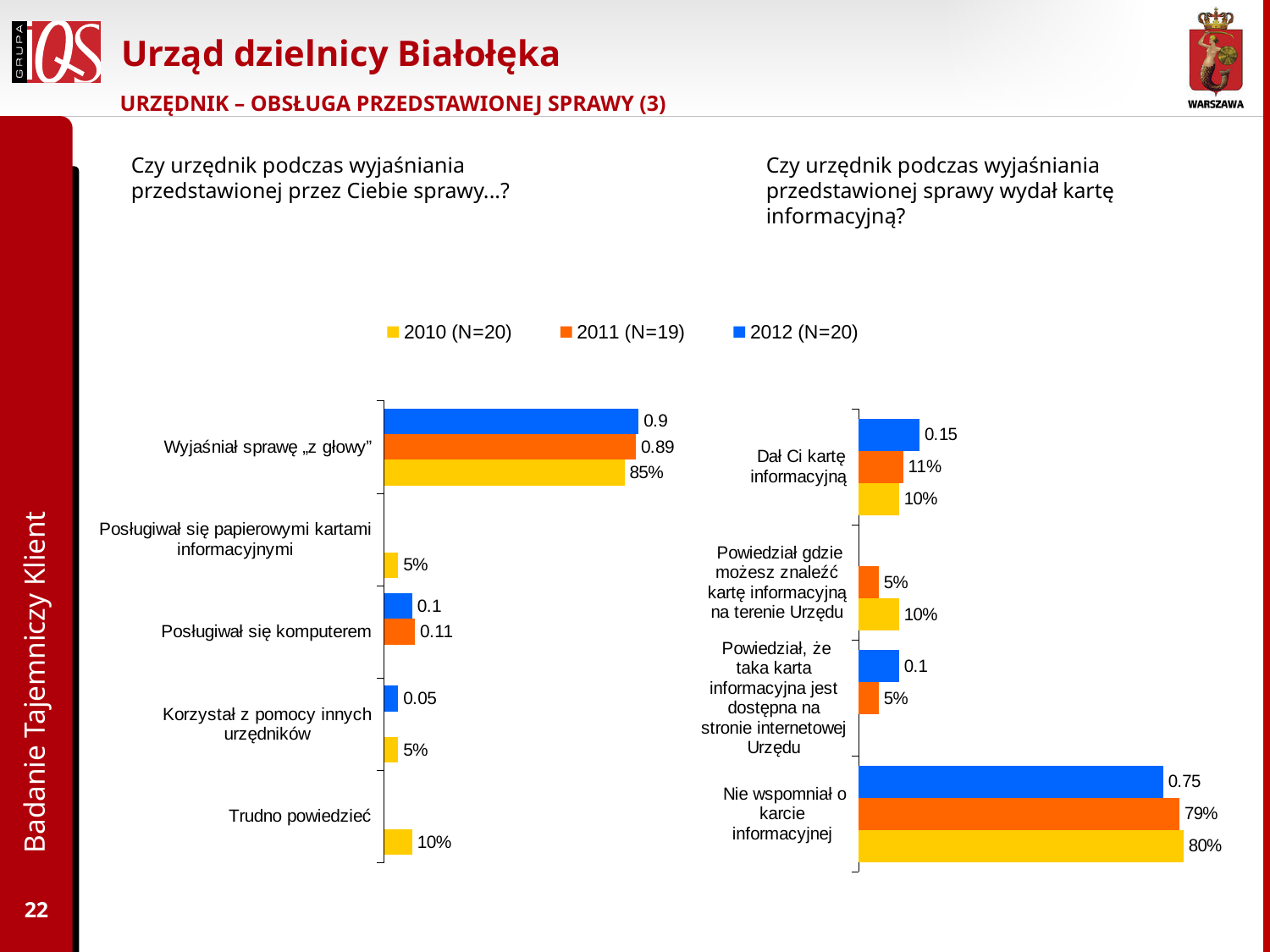
In the left chart, which category has the highest value for 2012 (N=20)? Wyjaśniał sprawę „z głowy” In the right chart, which is larger for "Nie wspomniał o karcie informacyjnej": the 2010 (N=20) value or the 2011 (N=19) value? 2010 (N=20) In the left chart, what is the value for 2011 (N=19) for "Posługiwał się komputerem"? 0.11 What kind of chart is the left chart? Bar chart In the right chart, what is the value for 2011 (N=19) for "Powiedział gdzie możesz znaleźć kartę informacyjną na terenie Urzędu"? 5% In the left chart, what is the value for 2010 (N=20) for "Wyjaśniał sprawę „z głowy”"? 85% In the right chart, which category has the highest value for 2011 (N=19)? Nie wspomniał o karcie informacyjnej In the left chart, what is the value for 2012 (N=20) for "Wyjaśniał sprawę „z głowy”"? 0.9 In the left chart, what is the value for 2010 (N=20) for "Trudno powiedzieć"? 10% How many series does the legend list? 3 In the right chart, what is the value for 2010 (N=20) for "Nie wspomniał o karcie informacyjnej"? 80% In the right chart, what is the value for 2012 (N=20) for "Dał Ci kartę informacyjną"? 0.15